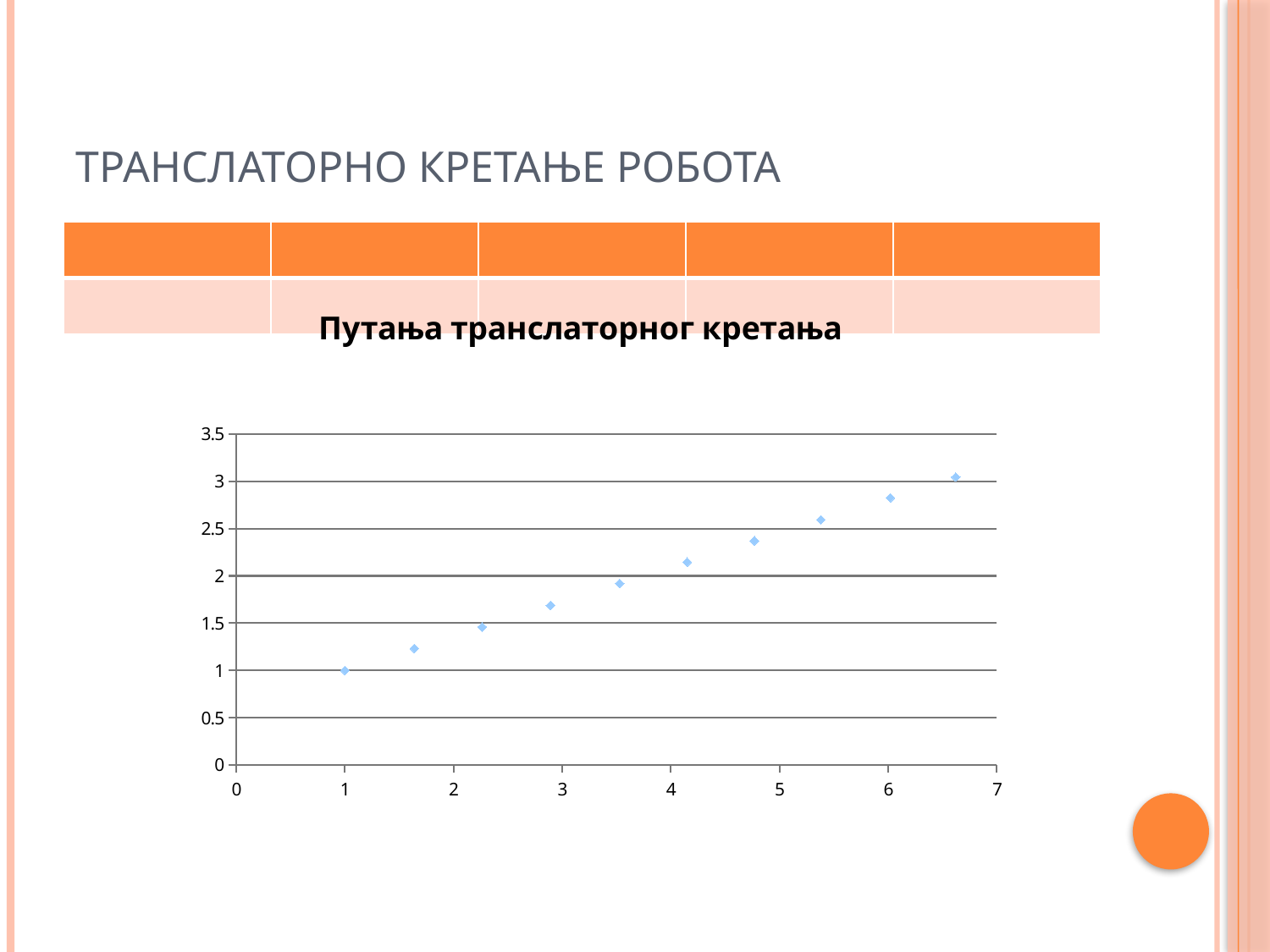
Is the value of the rightmost point greater or less than 3.5? less What kind of chart is shown on the slide? scatter chart What is the title of the chart? Путања транслаторног кретања Is the value of the point at about x = 1.6 greater or less than 1.5? less Is the value of the point at about x = 4.75 greater or less than 2.5? less What is the y value of the point plotted at x = 1? 1 Which point has the highest y value, the leftmost or the rightmost? the rightmost How many data points are plotted on the chart? 10 Do the plotted values rise or fall as x increases? rise What is the highest tick value shown on the y axis? 3.5